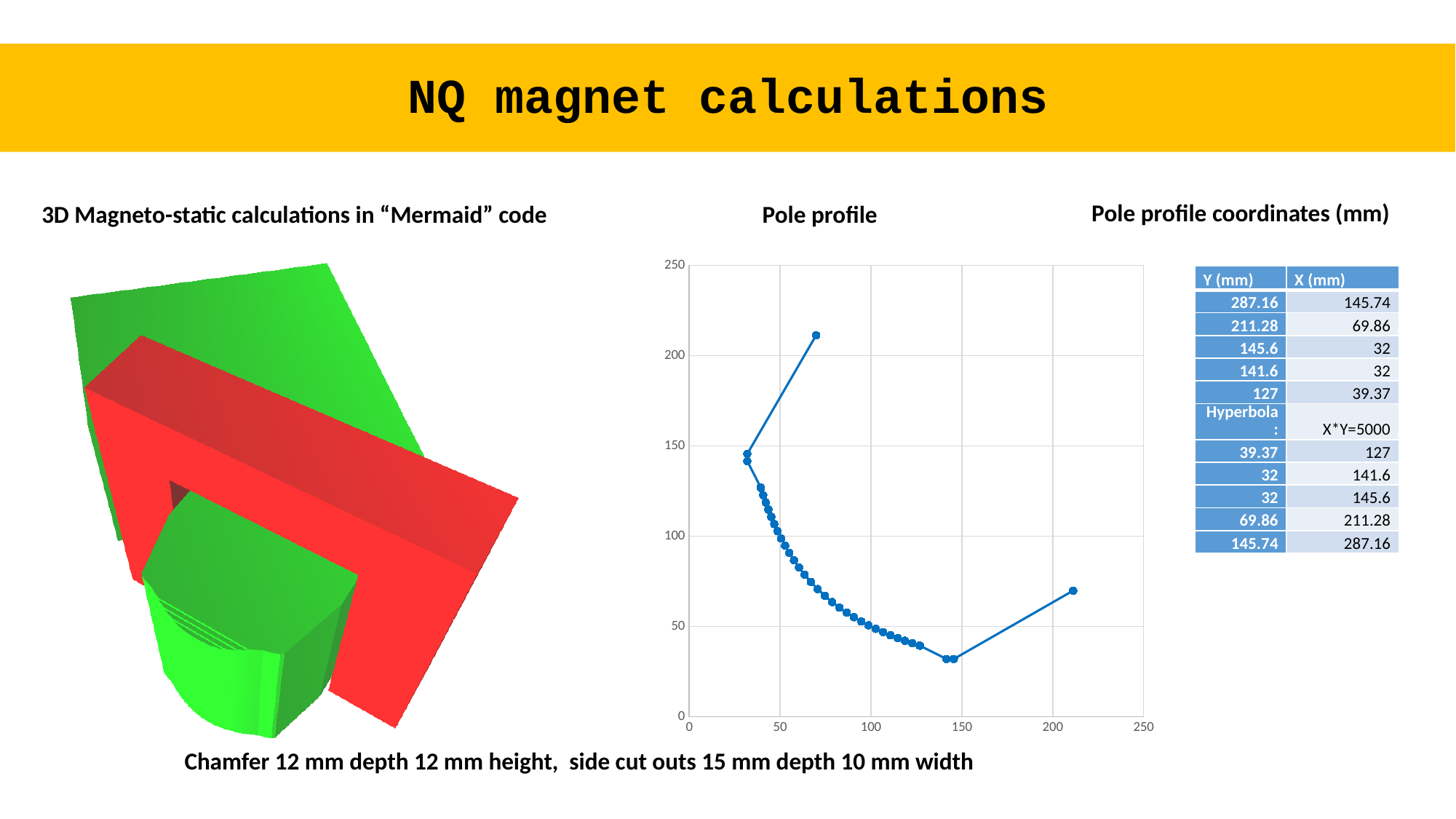
In the "Pole profile" chart, is the x value of the leftmost points greater or less than 50? less In the "Pole profile" chart, is the y value of the point near x = 100 greater or less than 100? less In the "Pole profile" chart, is the y value of the highest point greater or less than 200? greater In the "Pole profile" chart, do the y values rise or fall as x increases from about 50 to about 140? fall What is the title of the chart on the slide? Pole profile According to the "Pole profile coordinates (mm)" table next to the chart, what is X (mm) when Y (mm) is 127? 39.37 According to the "Pole profile coordinates (mm)" table next to the chart, what relation defines the hyperbola section of the profile? X*Y=5000 In the "Pole profile" chart, which point has the larger y value: the one near x = 70 or the one near x = 210? the one near x = 70 What kind of chart is the "Pole profile" chart? scatter chart In the "Pole profile" chart, what is the highest tick value shown on the x axis? 250